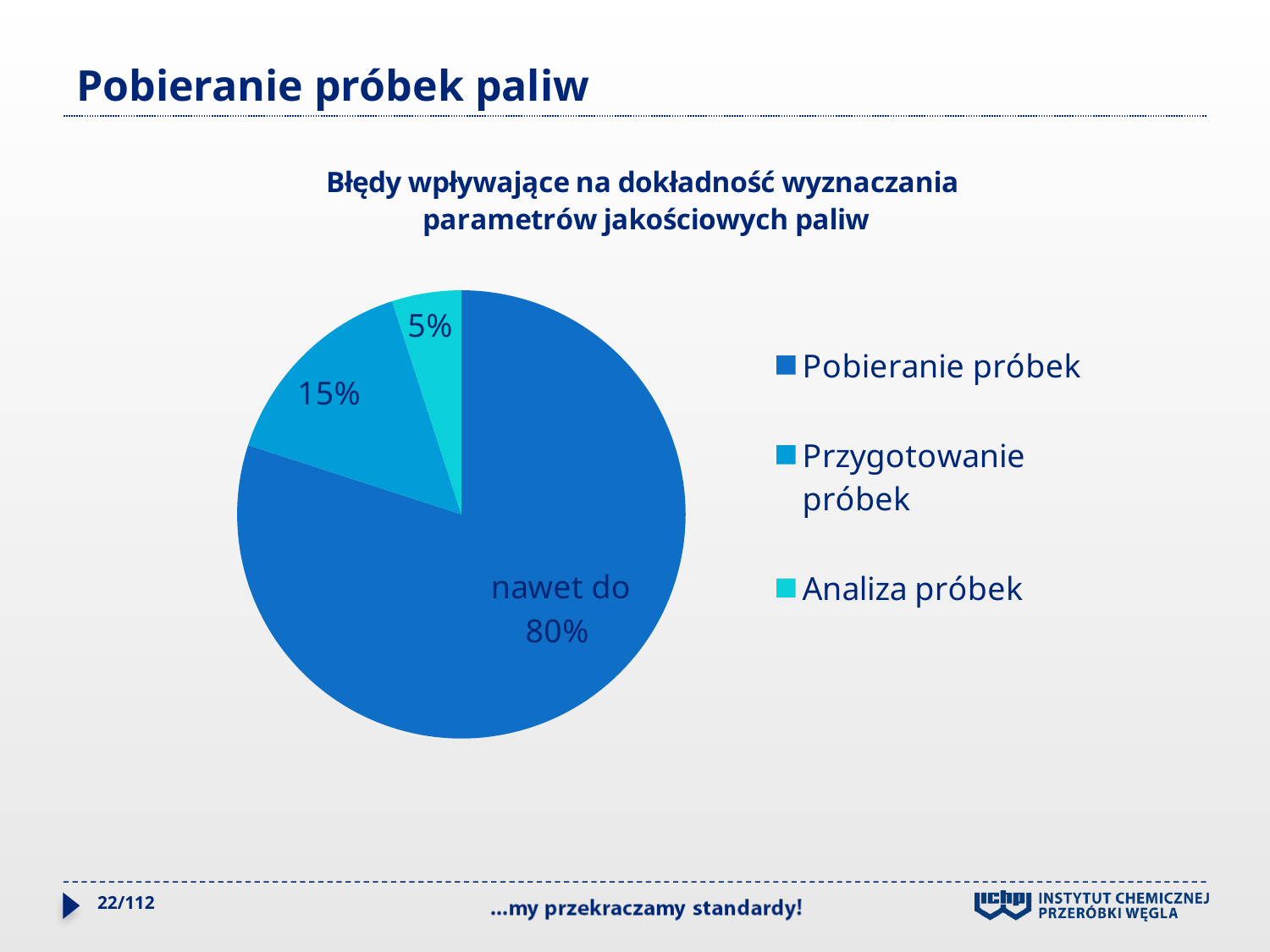
What kind of chart is shown on the slide? pie chart Which legend entry is shown in the lightest (cyan) colour? Analiza próbek Which category has the largest slice of the pie? Pobieranie próbek What share of the pie is labelled for Przygotowanie próbek? 15% By how many percentage points does the Przygotowanie próbek slice exceed the Analiza próbek slice? 10 percentage points What is the title of the chart? Błędy wpływające na dokładność wyznaczania parametrów jakościowych paliw Which category has the smallest slice of the pie? Analiza próbek How many entries does the legend list? 3 What label is printed on the Pobieranie próbek slice? nawet do 80% How many slices does the pie chart have? 3 Which slice is larger, Przygotowanie próbek or Analiza próbek? Przygotowanie próbek What share of the pie is labelled for Analiza próbek? 5%